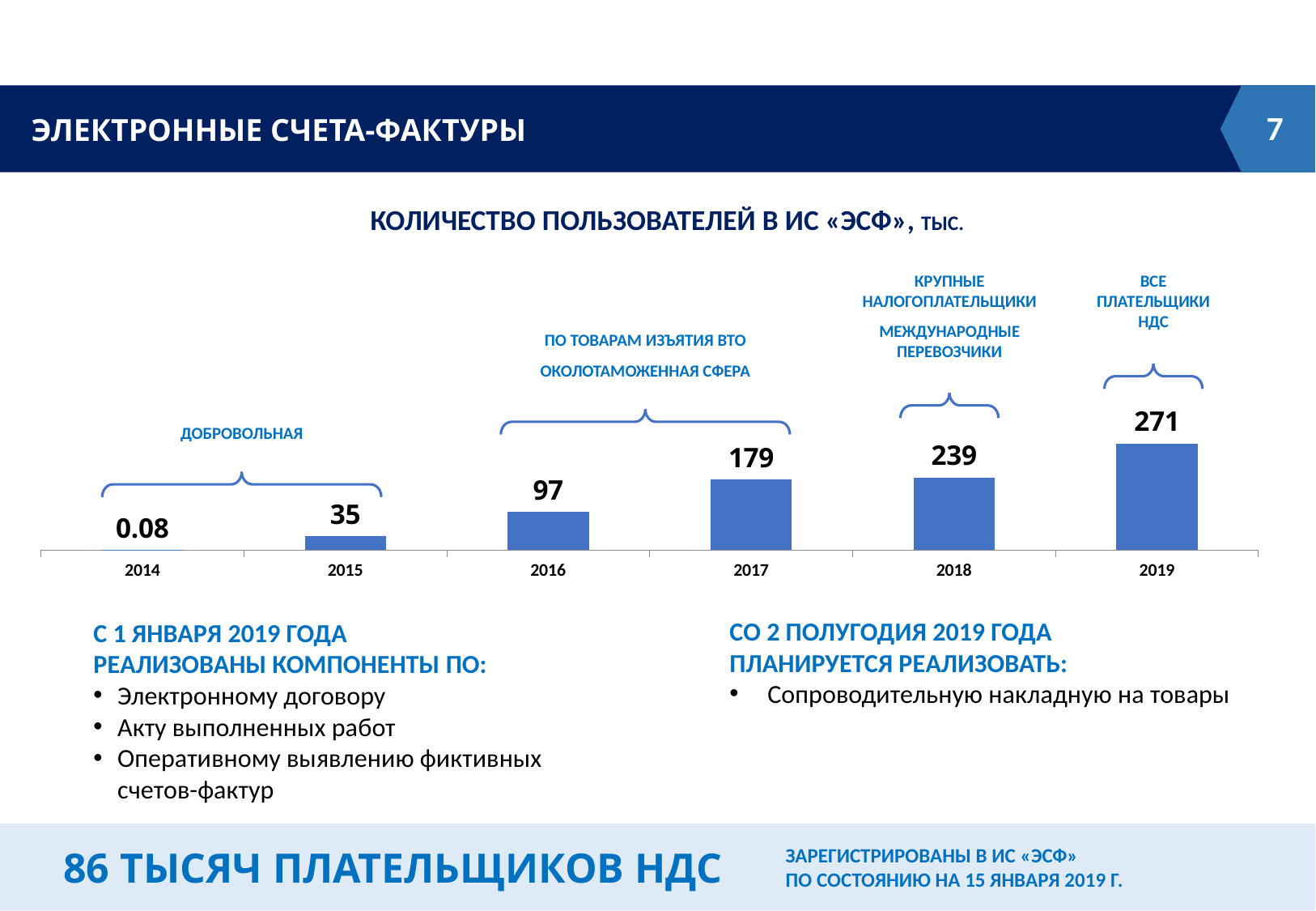
Do the values rise or fall from 2014 to 2019? rise What is the difference between the values for 2018 and 2017? 60 Which year has the highest value? 2019 What is the value for 2014? 0.08 What is the difference between the values for 2016 and 2015? 62 What is the value for 2019? 271 Which year has the lowest value? 2014 How many years are shown on the x axis? 6 What kind of chart is this? bar chart What is the value for 2017? 179 Which is larger, the value for 2016 or the value for 2018? 2018 What is the title of the chart? КОЛИЧЕСТВО ПОЛЬЗОВАТЕЛЕЙ В ИС «ЭСФ», тыс.